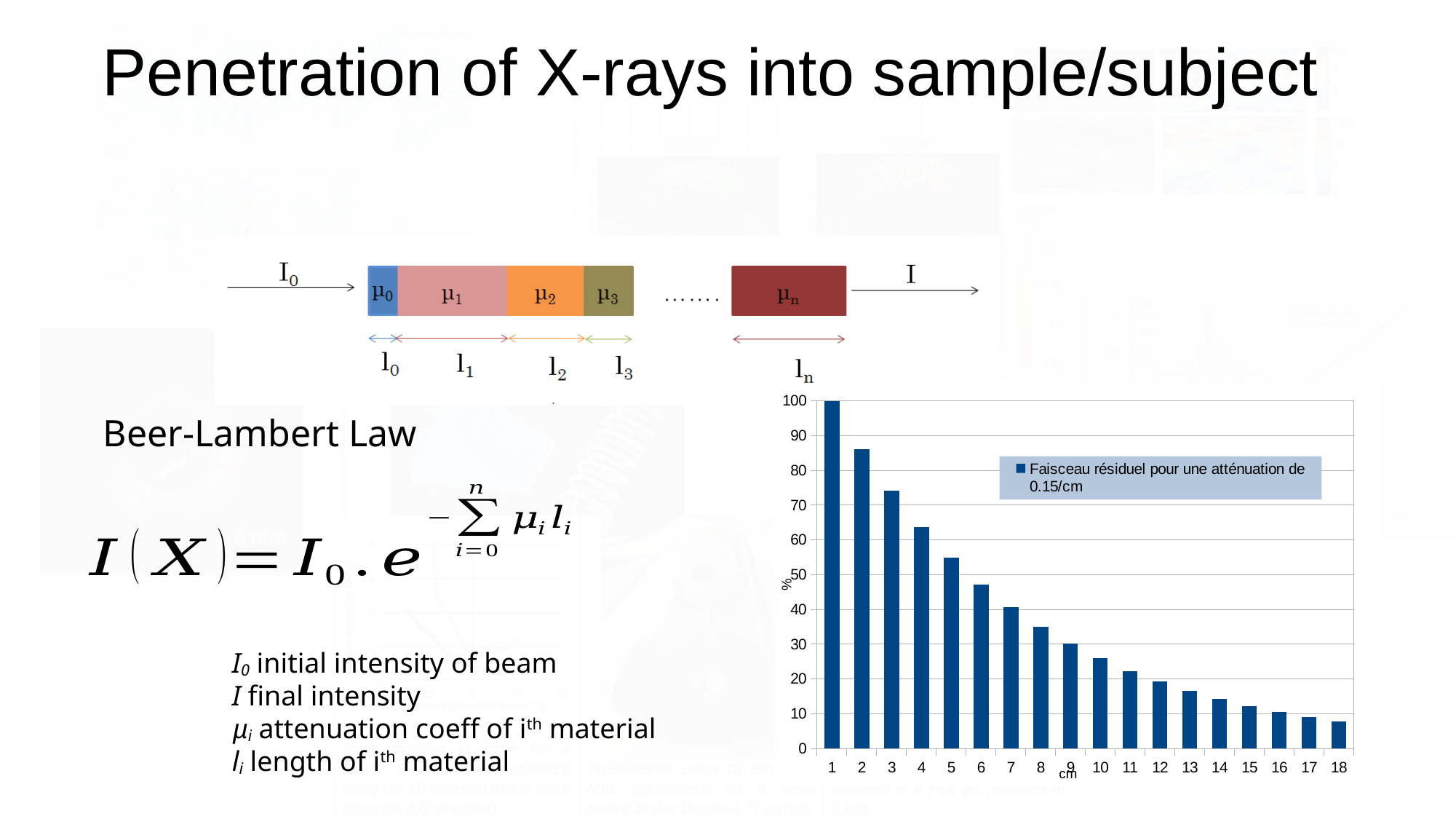
How many series does the chart legend list? 1 What is the legend entry of the series in the chart? Faisceau résiduel pour une atténuation de 0.15/cm Which cm category has the highest value in the chart? 1 What is the value for 1 cm in the chart? 100 Which cm category has the lowest value in the chart? 18 Is the value for 3 cm greater or less than 70? greater Do the values rise or fall as the cm value increases along the x axis? fall Is the value for 10 cm greater or less than 30? less Is the value for 5 cm greater or less than 50? greater What kind of chart is shown on the slide? bar chart How many bars (cm categories) are plotted in the chart? 18 Which is larger, the value for 4 cm or the value for 8 cm? 4 cm